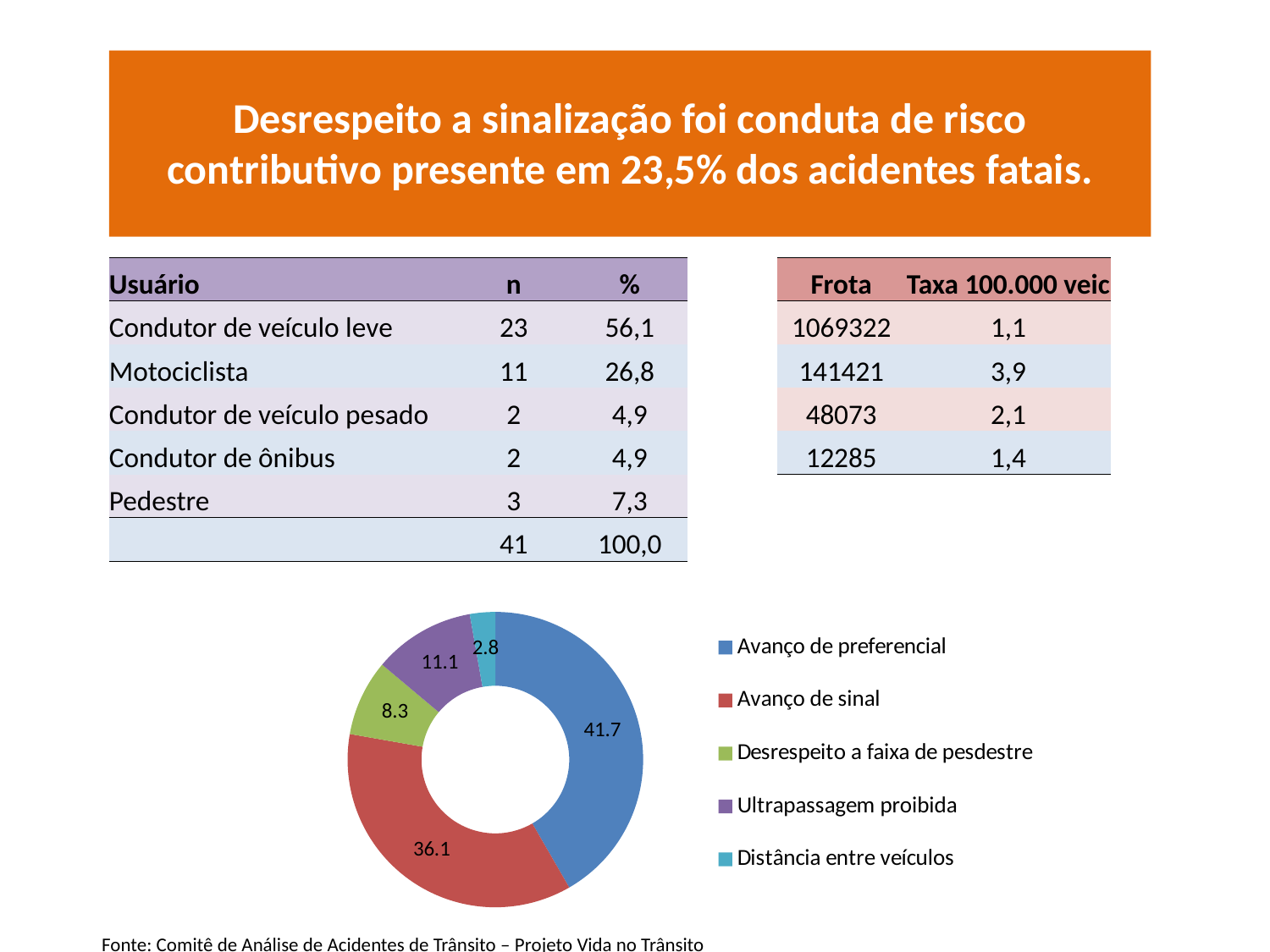
Which category has the largest slice in the doughnut chart? Avanço de preferencial What is the value for Ultrapassagem proibida in the doughnut chart? 11.1 What is the difference between the values for Avanço de preferencial and Avanço de sinal in the doughnut chart? 5.6 What is the value for Distância entre veículos in the doughnut chart? 2.8 What is the value for Desrespeito a faixa de pesdestre in the doughnut chart? 8.3 How many categories does the legend of the doughnut chart list? 5 What is the value for Avanço de sinal in the doughnut chart? 36.1 What is the value for Avanço de preferencial in the doughnut chart? 41.7 What colour is the slice for Avanço de sinal in the doughnut chart? Red Which category has the smallest slice in the doughnut chart? Distância entre veículos What kind of chart is shown on the slide? Doughnut chart Which is larger in the doughnut chart, Ultrapassagem proibida or Desrespeito a faixa de pesdestre? Ultrapassagem proibida